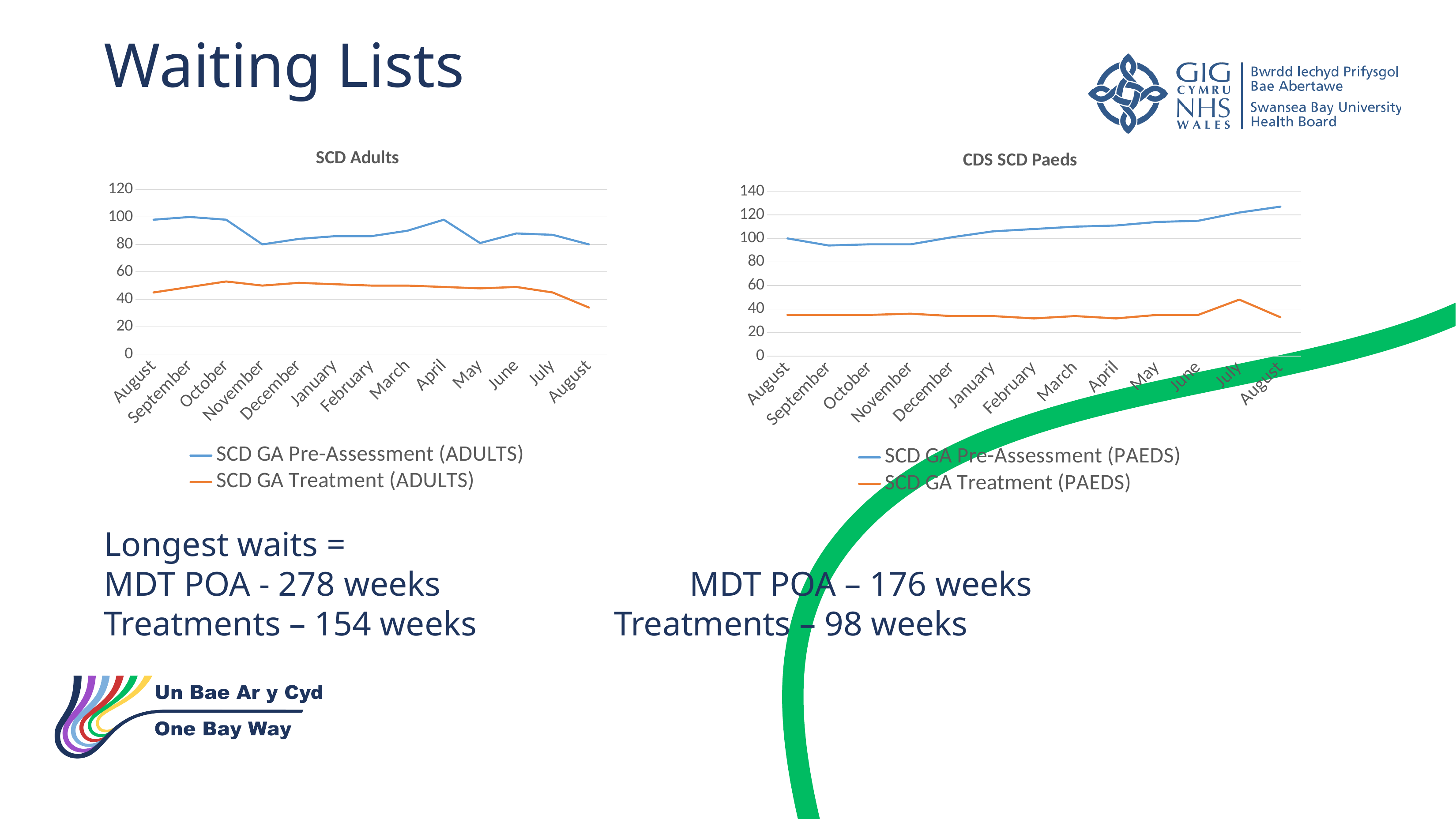
How many months are plotted along the x axis of the SCD Adults chart? 13 In the SCD Adults chart, is the value for SCD GA Pre-Assessment (ADULTS) in November greater or less than 100? less In the CDS SCD Paeds chart, is the value for SCD GA Treatment (PAEDS) in July greater or less than 40? greater In the SCD Adults chart, is the value for SCD GA Treatment (ADULTS) in October greater or less than 40? greater How many series does the legend of the CDS SCD Paeds chart list? 2 In the CDS SCD Paeds chart, does SCD GA Pre-Assessment (PAEDS) generally rise or fall from the first August to the last August? rise In the CDS SCD Paeds chart, which series has the larger value at the final August point, SCD GA Pre-Assessment (PAEDS) or SCD GA Treatment (PAEDS)? SCD GA Pre-Assessment (PAEDS) What kind of chart is the SCD Adults chart? line chart In the CDS SCD Paeds chart, in which month does SCD GA Pre-Assessment (PAEDS) reach its highest value? August (final point) In the SCD Adults chart, in which month is SCD GA Treatment (ADULTS) at its lowest? August (final point) In the CDS SCD Paeds chart, in which month does SCD GA Treatment (PAEDS) reach its highest value? July